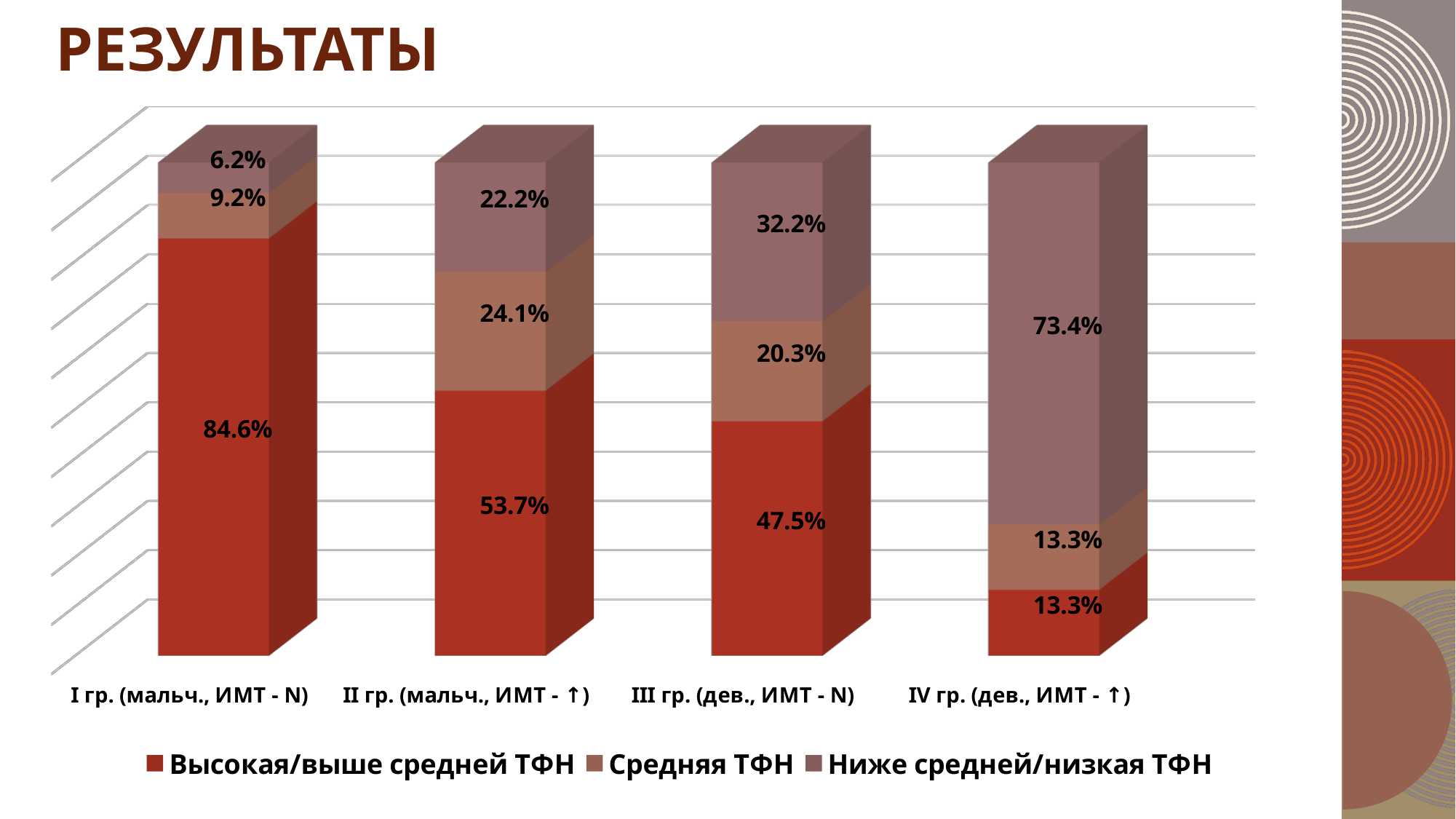
What is the difference between the Высокая/выше средней ТФН values for I гр. (мальч., ИМТ - N) and II гр. (мальч., ИМТ - ↑)? 30.9% What is the value of Высокая/выше средней ТФН for I гр. (мальч., ИМТ - N)? 84.6% How many categories (groups) are shown on the x axis? 4 What is the title of the slide containing the chart? РЕЗУЛЬТАТЫ How many series does the legend list? 3 Which group has the highest value for Ниже средней/низкая ТФН? IV гр. (дев., ИМТ - ↑) What kind of chart is shown on the slide? Stacked bar chart Does the Высокая/выше средней ТФН value rise or fall from I гр. to IV гр. along the x axis? Fall Which group has the lowest value for Высокая/выше средней ТФН? IV гр. (дев., ИМТ - ↑) What is the value of Средняя ТФН for II гр. (мальч., ИМТ - ↑)? 24.1% What is the value of Ниже средней/низкая ТФН for IV гр. (дев., ИМТ - ↑)? 73.4% Which is larger: Ниже средней/низкая ТФН for III гр. (дев., ИМТ - N) or for II гр. (мальч., ИМТ - ↑)? III гр. (дев., ИМТ - N)